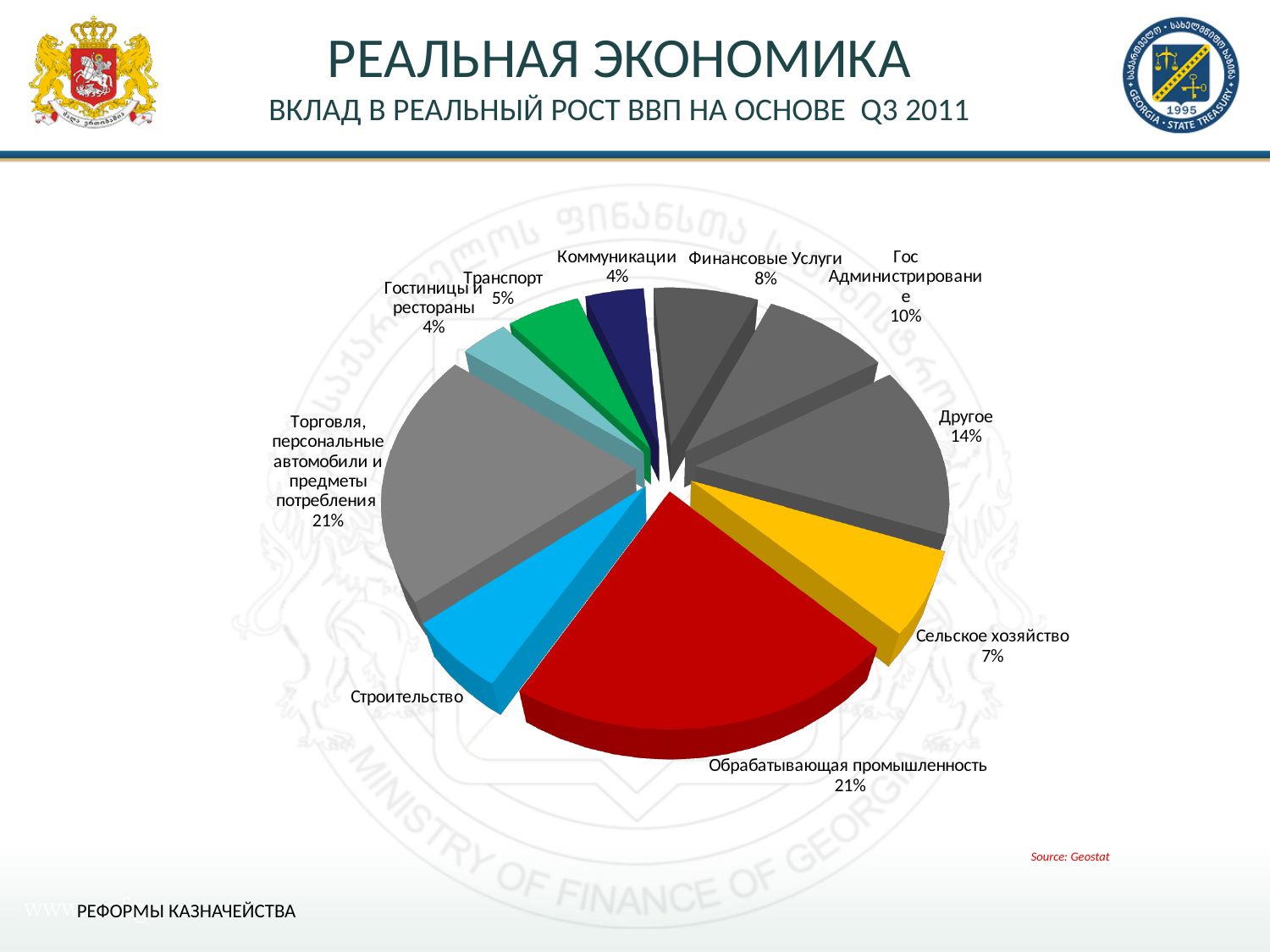
What share of real GDP growth is attributed to Обрабатывающая промышленность? 21% What share is shown for Финансовые Услуги? 8% What share is shown for Транспорт? 5% What share is shown for Торговля, персональные автомобили и предметы потребления? 21% How many slices does the pie chart have? 10 What share is shown for Гос Администрирование? 10% Which is larger, the share for Другое or the share for Сельское хозяйство? Другое What kind of chart is shown on the slide? pie chart What share is shown for Другое? 14% What is the difference in percentage points between the shares for Другое and Гос Администрирование? 4 What share is shown for Сельское хозяйство? 7% What is the source cited for the chart? Geostat